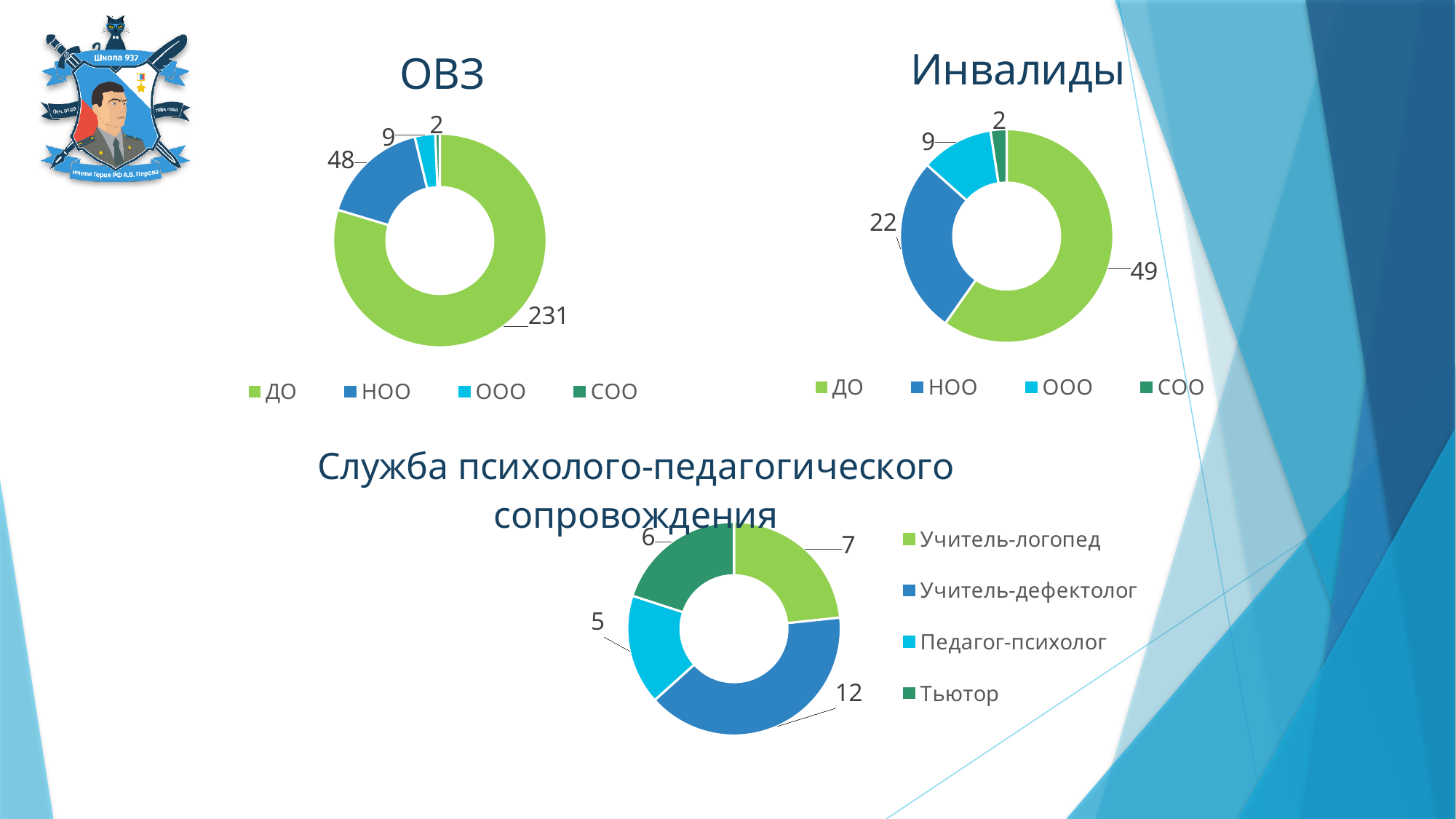
How many categories does the legend of the Инвалиды chart list? 4 In the Инвалиды chart, which category has the largest value? ДО In the ОВЗ chart, what is the value for НОО? 48 In the Служба психолого-педагогического сопровождения chart, which is larger: Учитель-логопед or Тьютор? Учитель-логопед In the Инвалиды chart, which category has the smallest value? СОО In the Служба психолого-педагогического сопровождения chart, what is the value for Учитель-дефектолог? 12 What type of chart is the ОВЗ chart? Doughnut chart What is the total of all values in the Служба психолого-педагогического сопровождения chart? 30 In the ОВЗ chart, what is the value for ДО? 231 In the ОВЗ chart, what is the difference between the values for ДО and НОО? 183 In the Инвалиды chart, what is the value for НОО? 22 In the Служба психолого-педагогического сопровождения chart, which category has the smallest value? Педагог-психолог